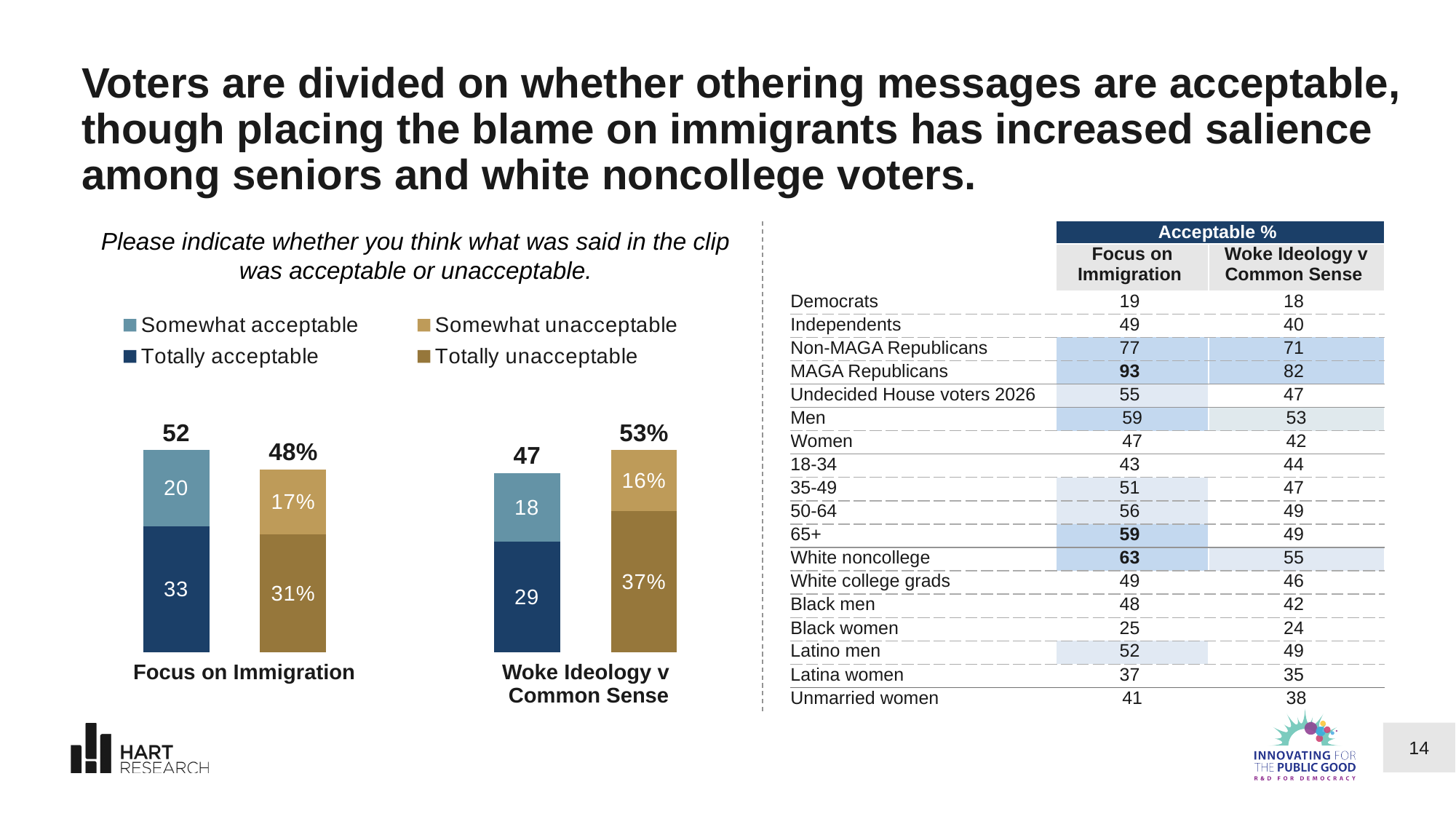
What is the Totally unacceptable value for Woke Ideology v Common Sense? 37% How many series does the chart legend list? 4 What kind of chart is shown on the left of the slide? Stacked bar chart Which message has the higher total acceptable value, Focus on Immigration or Woke Ideology v Common Sense? Focus on Immigration What is the Somewhat acceptable value for Focus on Immigration? 20 What is the total unacceptable share for Woke Ideology v Common Sense? 53% Which segment is the largest in the Woke Ideology v Common Sense bars? Totally unacceptable (37%) Which colour represents Totally acceptable in the chart? Dark blue What is the Totally acceptable value for Focus on Immigration? 33 What is the difference between the Totally unacceptable values for Woke Ideology v Common Sense and Focus on Immigration? 6% What is the Somewhat unacceptable value for Woke Ideology v Common Sense? 16% What is the total acceptable share for Focus on Immigration? 52